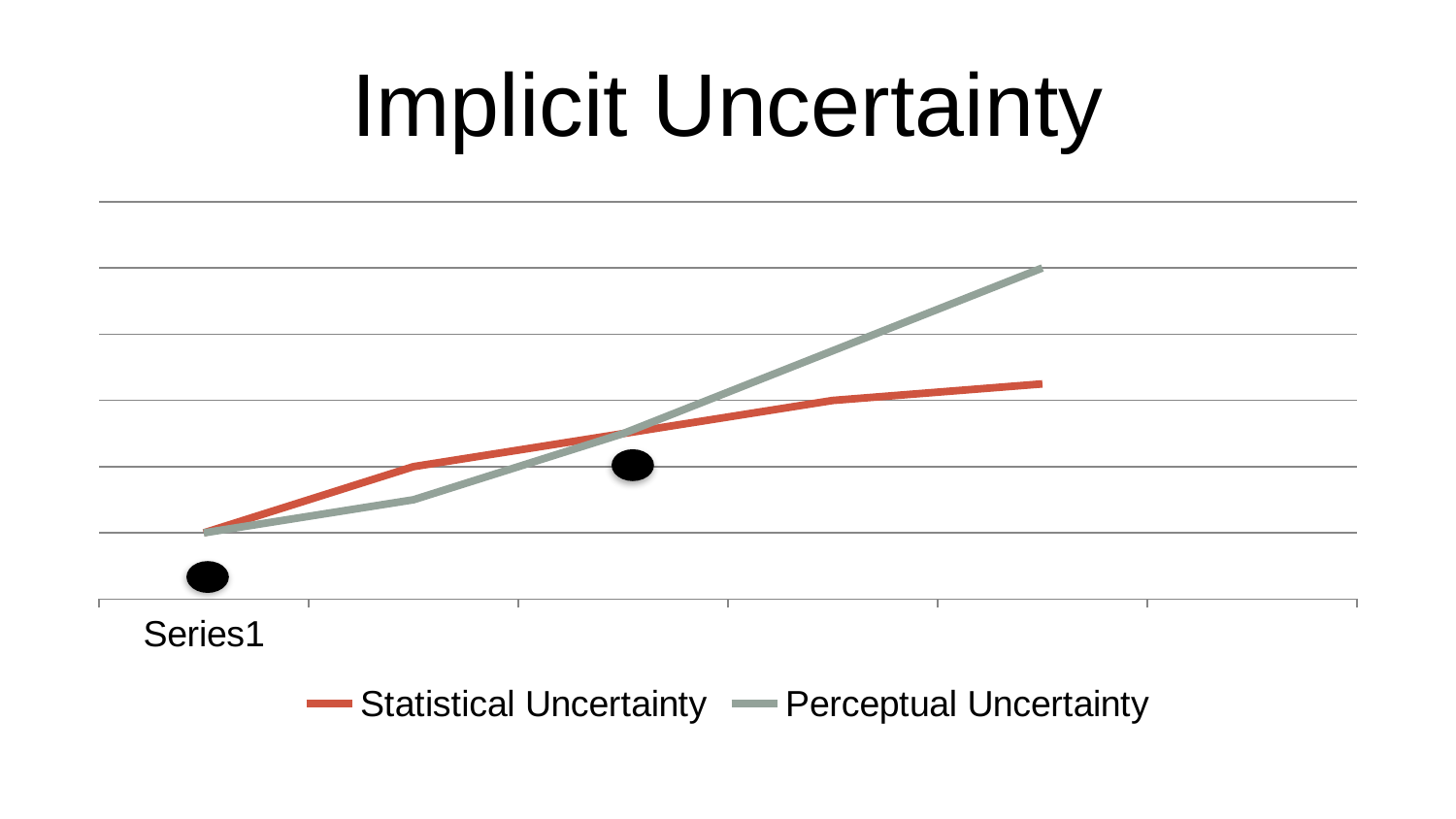
At the second point from the left, which series has the higher value, Statistical Uncertainty or Perceptual Uncertainty? Statistical Uncertainty How many series does the legend list? 2 Do the values for Statistical Uncertainty rise or fall along the x axis? Rise Do the values for Perceptual Uncertainty rise or fall along the x axis? Rise What kind of chart is shown on the slide? Line chart At the right end of the chart, which series has the higher value, Statistical Uncertainty or Perceptual Uncertainty? Perceptual Uncertainty What is the title of the chart? Implicit Uncertainty Which series is drawn in red/orange? Statistical Uncertainty What is the only category label shown on the x axis? Series1 Which series reaches the highest value on the chart? Perceptual Uncertainty